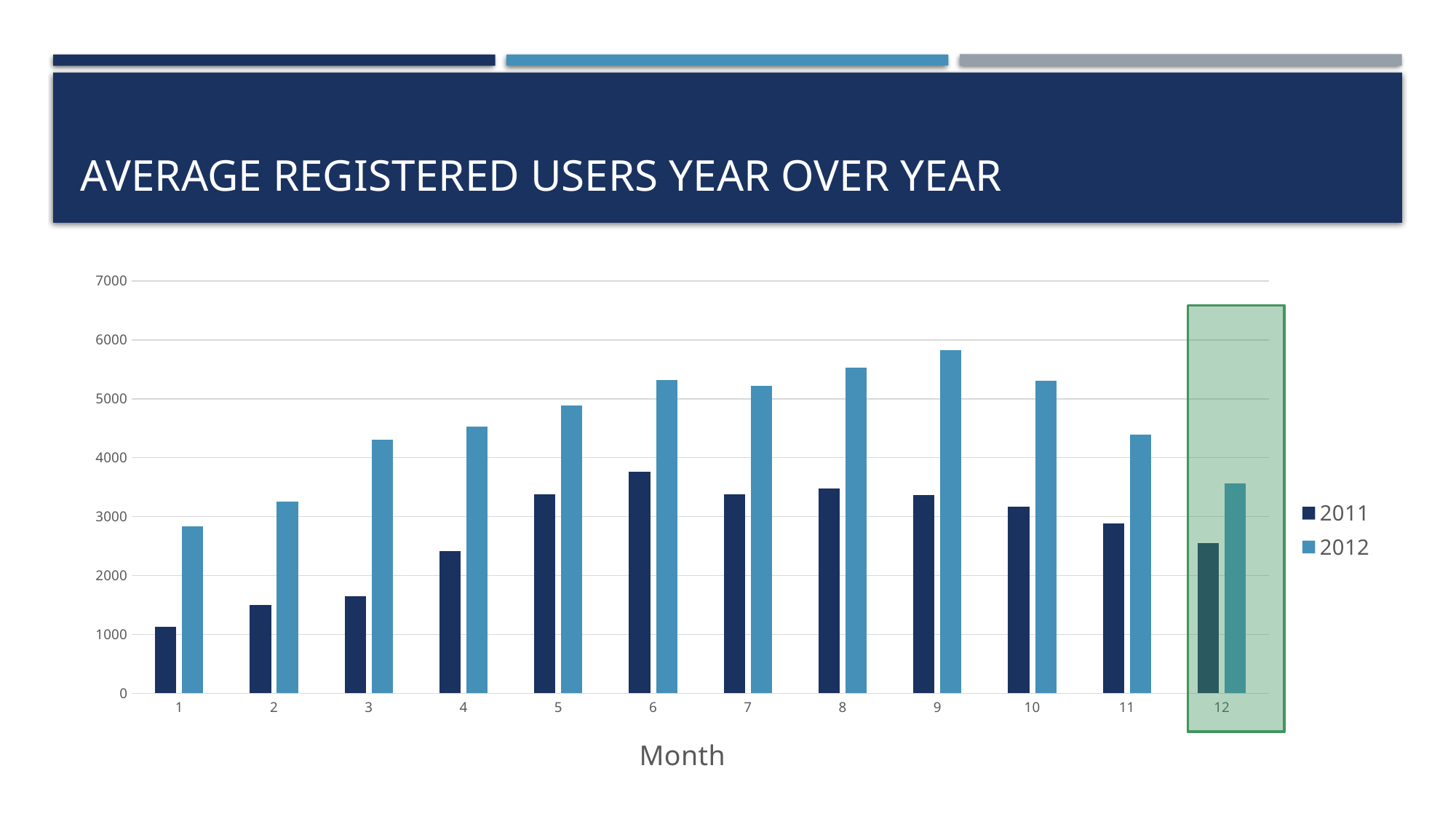
In which month is the 2011 value lowest? 1 How many series does the legend list? 2 In which month is the 2012 value highest? 9 What kind of chart is shown on the slide? bar chart Is the 2012 value for month 3 greater or less than 4000? greater In which month is the 2012 value lowest? 1 How many months are shown on the x axis? 12 Is the 2011 value for month 1 greater or less than 2000? less What is the title of the x axis? Month Is the 2012 value for month 9 greater or less than 5000? greater In which month is the 2011 value highest? 6 For month 6, which series has the larger value, 2011 or 2012? 2012